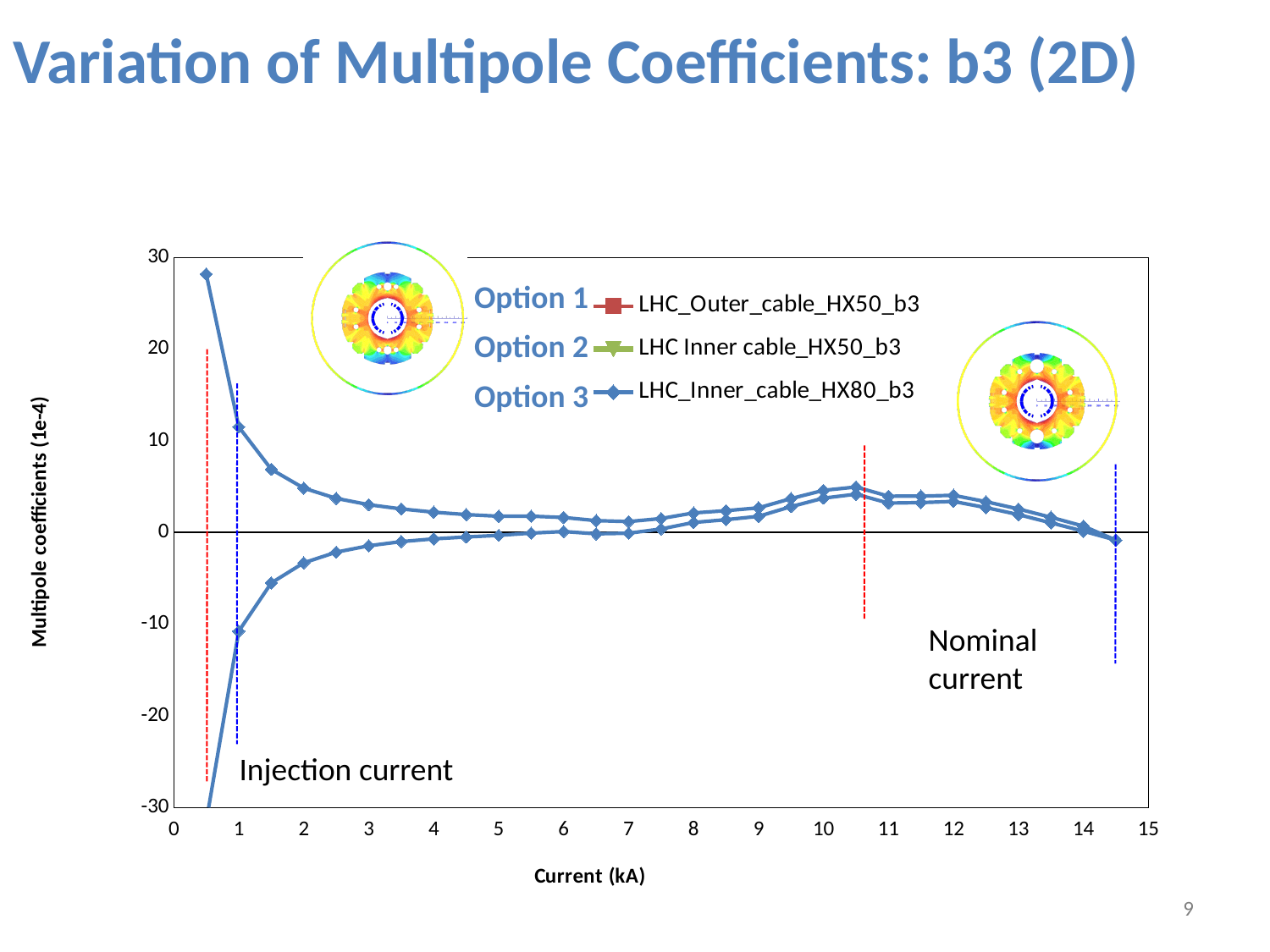
What kind of chart is shown on the slide? Line chart Is the lowest plotted value at 0.5 kA greater or less than -20? less What is the label of the y axis of the chart? Multipole coefficients (1e-4) Is the lowest plotted value at 1 kA greater or less than 0? less Does the lowermost line rise or fall as the current increases from 0.5 kA to 7 kA? rise Does the uppermost line rise or fall as the current increases from 0.5 kA to 7 kA? fall How many series does the chart legend list? 3 Is the highest plotted value at 10.5 kA greater or less than 10? less What is the maximum value shown on the x axis of the chart? 15 What is the label of the x axis of the chart? Current (kA)